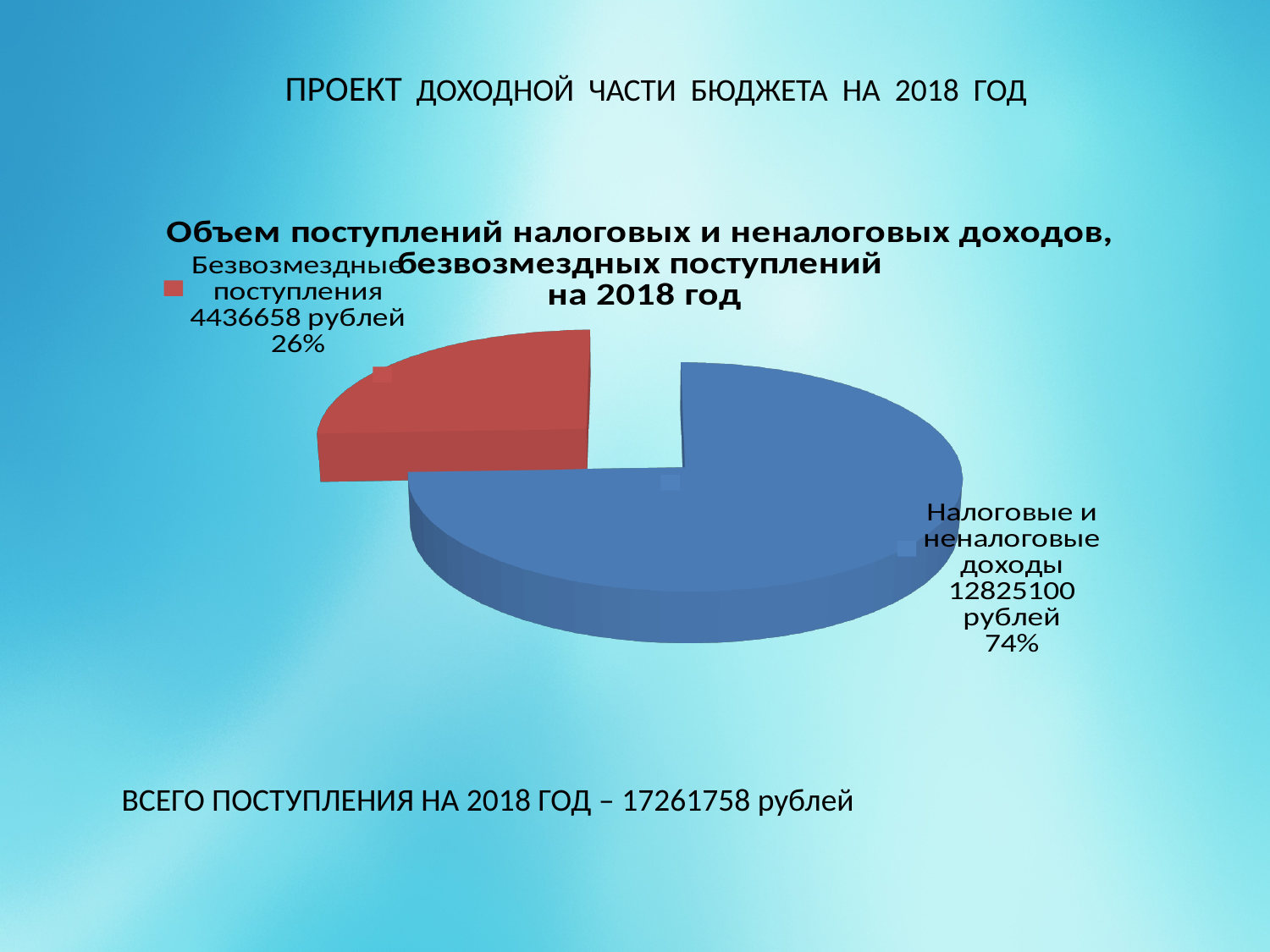
Which category has the smallest slice of the pie? Безвозмездные поступления What is the total of the two slices in rubles? 17261758 рублей Which category has the largest slice of the pie? Налоговые и неналоговые доходы How many slices does the pie chart have? 2 What kind of chart is shown on the slide? Pie chart Which is larger: "Налоговые и неналоговые доходы" or "Безвозмездные поступления"? Налоговые и неналоговые доходы What is the value shown for "Налоговые и неналоговые доходы"? 12825100 рублей What is the value shown for "Безвозмездные поступления"? 4436658 рублей What is the difference in rubles between "Налоговые и неналоговые доходы" and "Безвозмездные поступления"? 8388442 рублей What colour is the slice for "Безвозмездные поступления"? Red What share of the pie does "Безвозмездные поступления" represent? 26% What share of the pie does "Налоговые и неналоговые доходы" represent? 74%